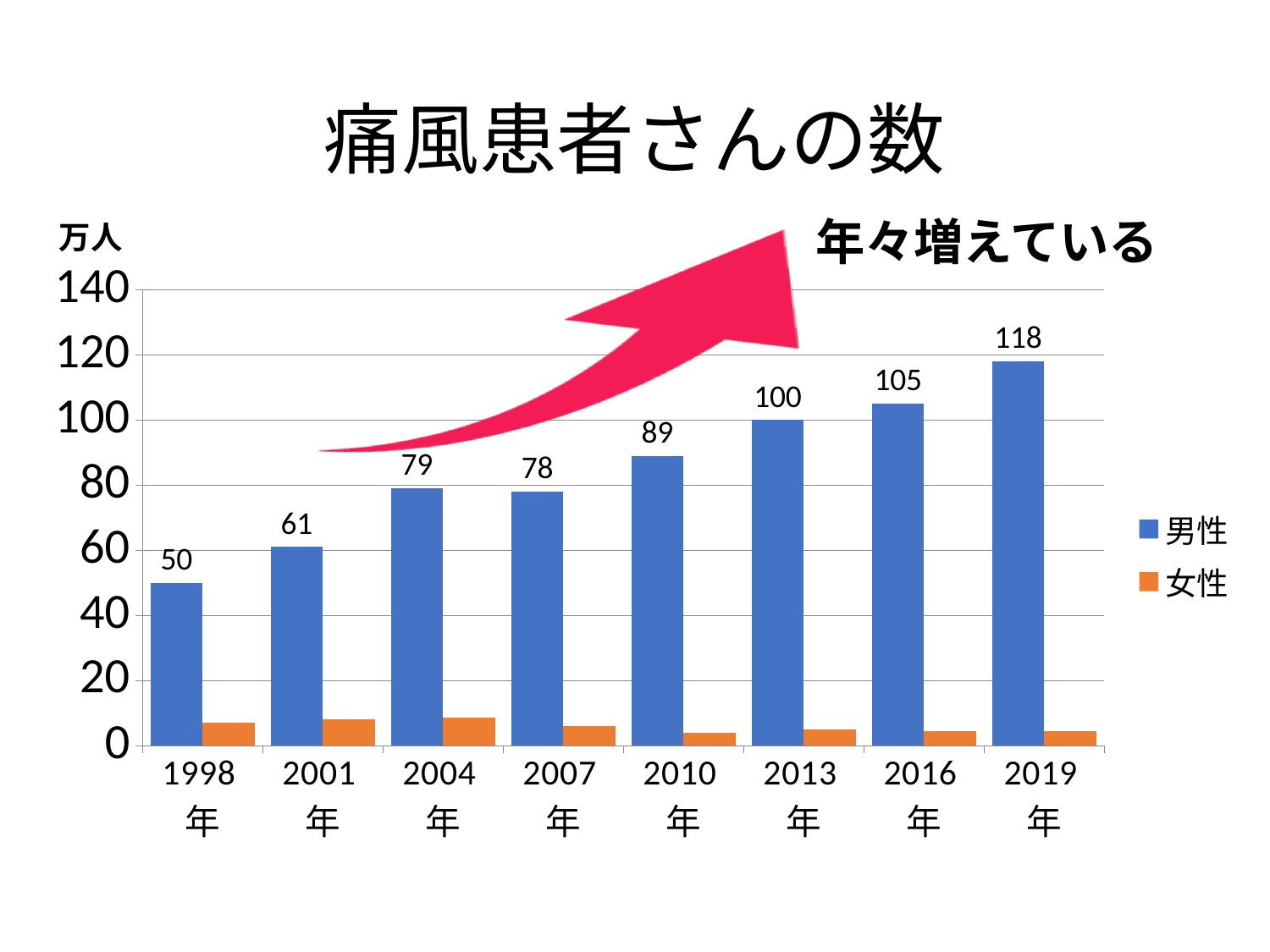
What is the value for 男性 in 1998年? 50 What is the value for 男性 in 2019年? 118 What is the value for 男性 in 2010年? 89 Which year has the highest value for 男性? 2019年 Which year has the lowest value for 男性? 1998年 What is the title of the chart? 痛風患者さんの数 What kind of chart is shown on the slide? bar chart What is the difference between the 男性 values for 2019年 and 1998年? 68 Is the value for 女性 in 2004年 greater or less than 20? less How many series does the legend list? 2 How many years are shown on the x axis? 8 Which is larger, the 男性 value for 2004年 or for 2007年? 2004年